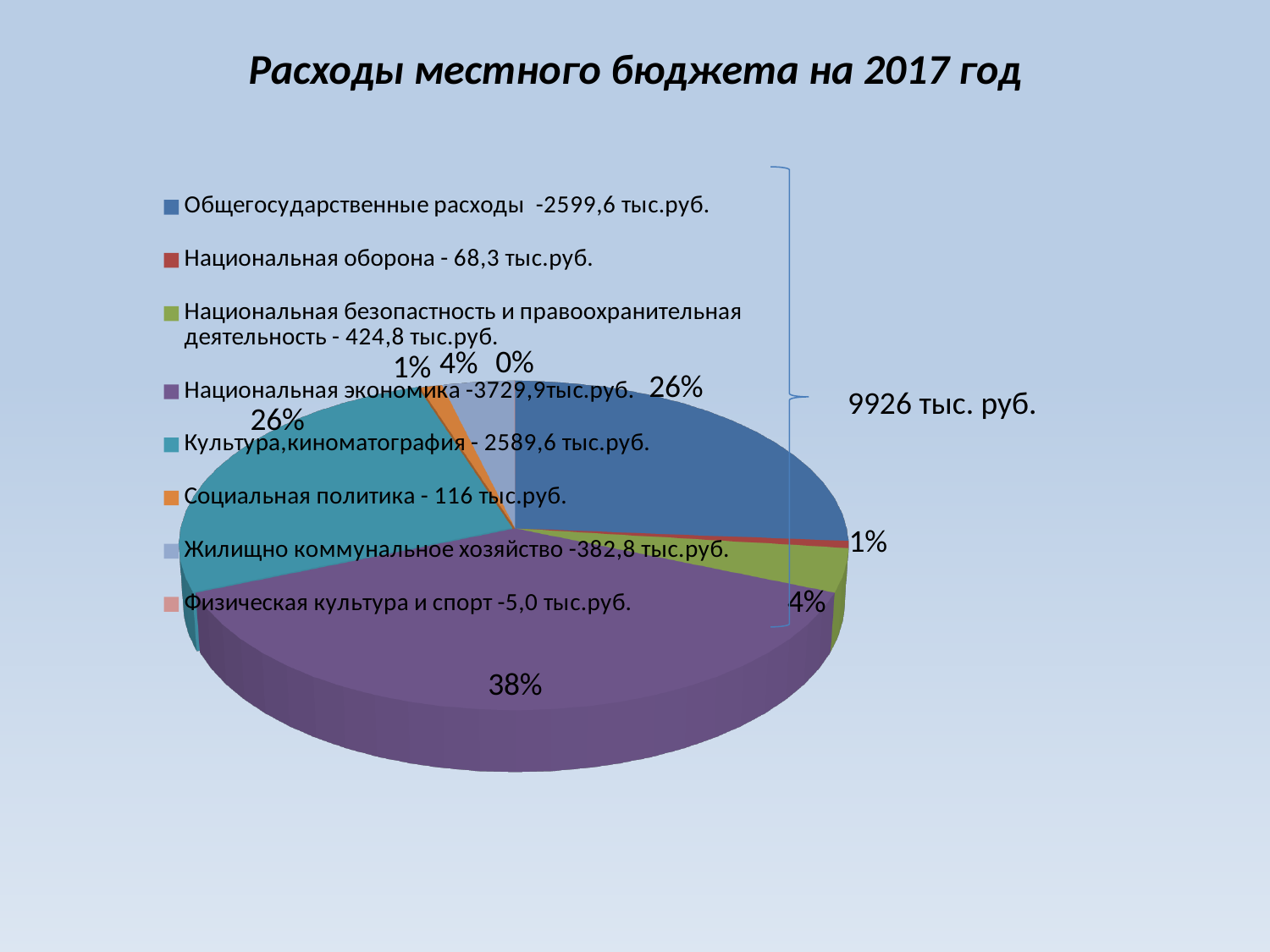
Which category has the largest slice of the pie? Национальная экономика What share of the pie does Культура,киноматография take? 26% What share of the pie does Национальная экономика take? 38% Which is larger, Общегосударственные расходы or Культура,киноматография? Общегосударственные расходы What is the value for Национальная экономика? 3729,9 тыс.руб. What is the value for Национальная оборона? 68,3 тыс.руб. How many expenditure categories does the legend list? 8 Which category has the smallest value? Физическая культура и спорт What total amount is shown next to the bracket on the right of the chart? 9926 тыс. руб. What is the value for Жилищно коммунальное хозяйство? 382,8 тыс.руб. What is the difference between Национальная экономика and Общегосударственные расходы? 1130,3 тыс.руб. What kind of chart is shown on the slide? pie chart